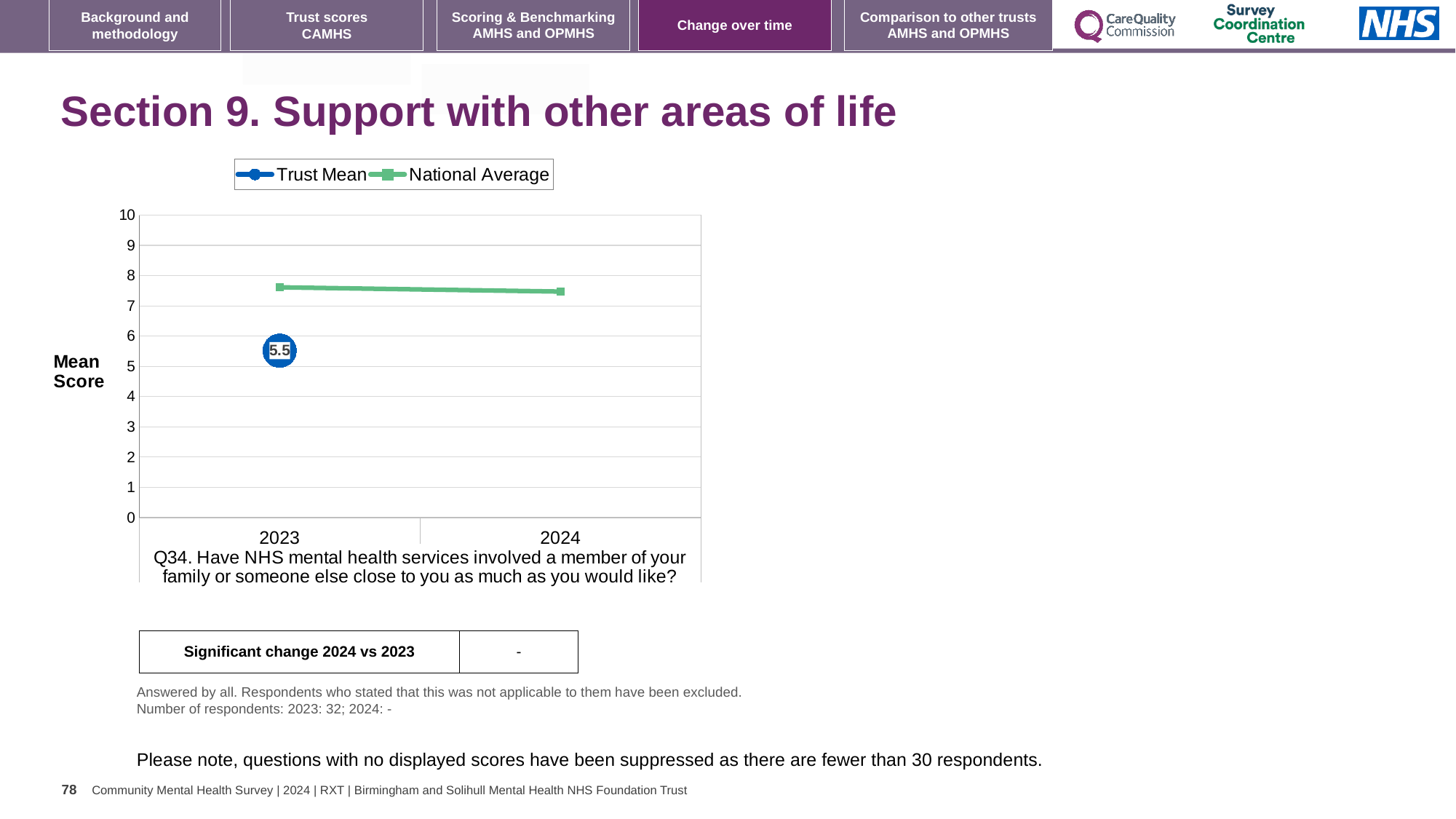
How many series does the legend list? 2 How many years are shown on the x axis? 2 Does the National Average rise or fall from 2023 to 2024? Fall Is the National Average value for 2024 greater or less than 7? greater In 2023, which is higher: the Trust Mean or the National Average? National Average Is the National Average value for 2023 greater or less than 7? greater What are the two series named in the legend? Trust Mean and National Average What is the Trust Mean score for 2023? 5.5 What is the label on the y axis of the chart? Mean Score Is the Trust Mean value for 2023 greater or less than 6? less What kind of chart is shown on the slide? Line chart